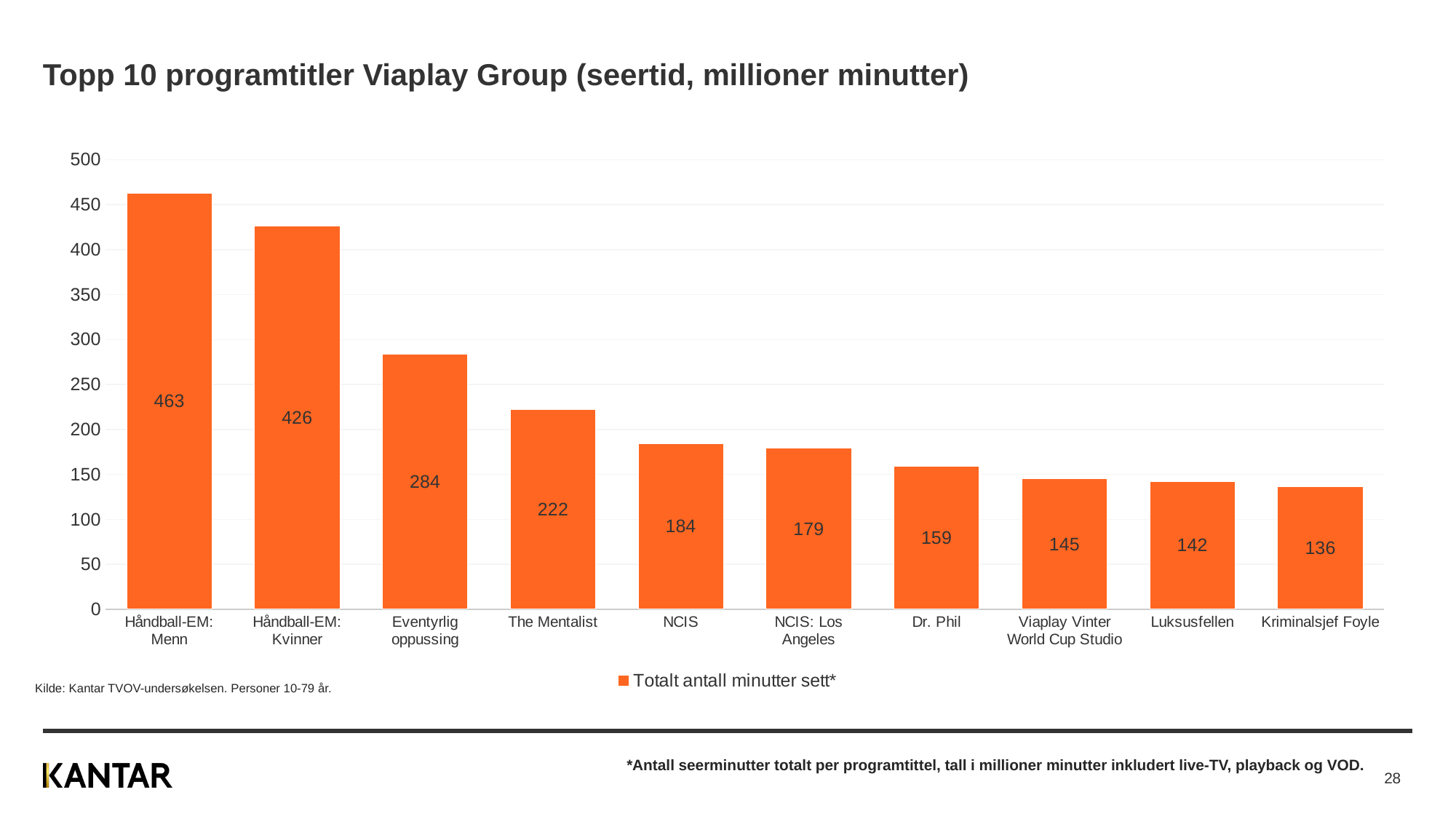
Is the value for Eventyrlig oppussing greater or less than 250? greater What is the value for Håndball-EM: Menn? 463 What is the value for Viaplay Vinter World Cup Studio? 145 What is the legend entry for the series shown in the chart? Totalt antall minutter sett* How many program titles are shown in the chart? 10 What is the difference between the values for Håndball-EM: Menn and Håndball-EM: Kvinner? 37 What kind of chart is shown on the slide? bar chart Which has a larger value, NCIS or NCIS: Los Angeles? NCIS Which program title has the highest value? Håndball-EM: Menn Which program title has the lowest value? Kriminalsjef Foyle What is the difference between the values for Eventyrlig oppussing and Dr. Phil? 125 What is the value for The Mentalist? 222